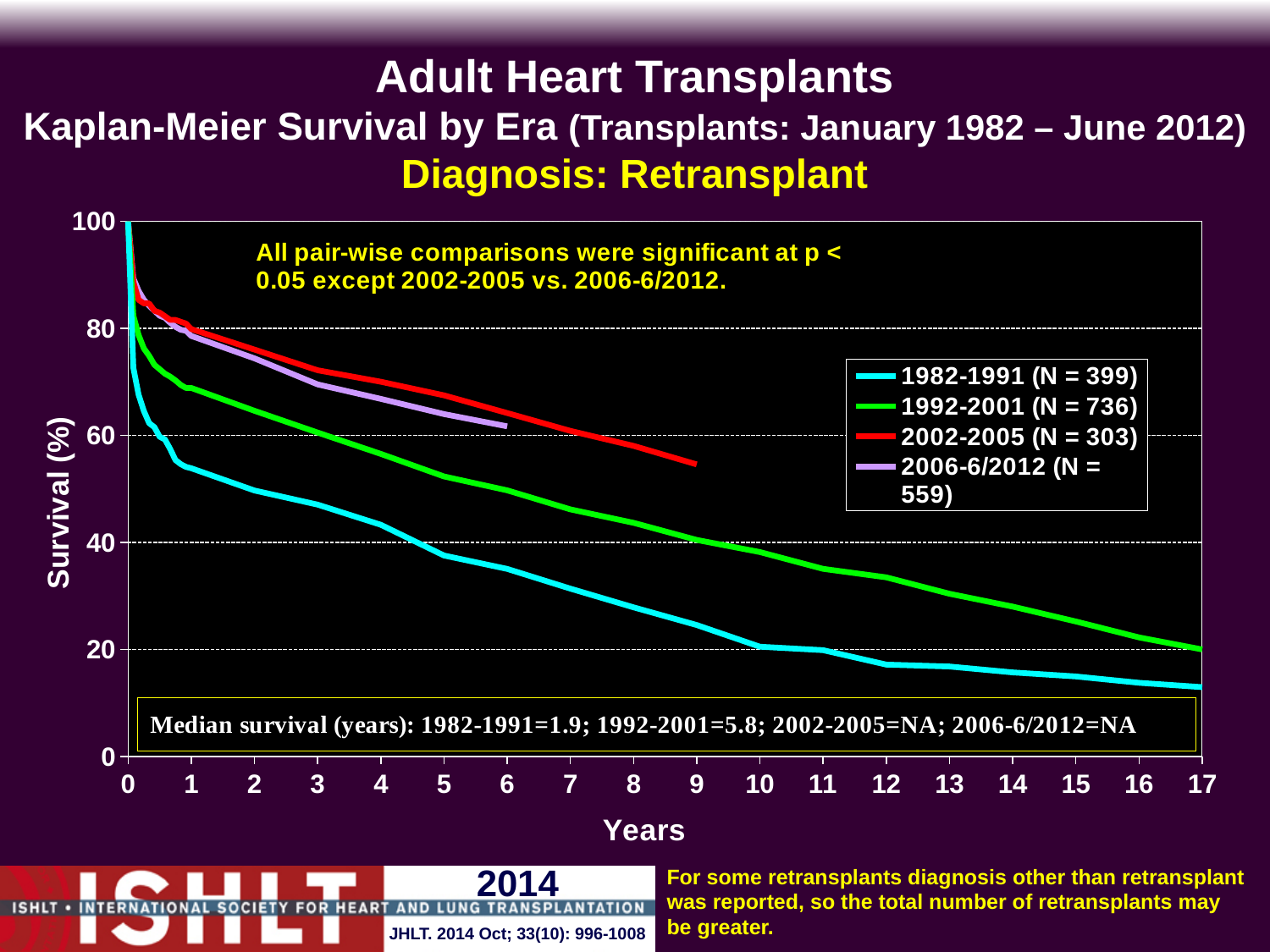
What is the difference in median survival (years) between the 1992-2001 era and the 1982-1991 era? 3.9 Do the survival curves rise or fall as years increase? fall What is the N for the 1992-2001 era shown in the legend? 736 What is the median survival in years for the 1992-2001 era? 5.8 At 5 years, which era has higher survival: 1982-1991 or 1992-2001? 1992-2001 Is the survival for the 1982-1991 era at 5 years greater or less than 40? less Which era has the lowest survival at 5 years? 1982-1991 What is the median survival reported for the 2002-2005 era? NA How many series (eras) does the legend list? 4 What is the median survival in years for the 1982-1991 era? 1.9 Is the survival for the 2002-2005 era at 5 years greater or less than 60? greater What type of chart is shown on the slide? line chart